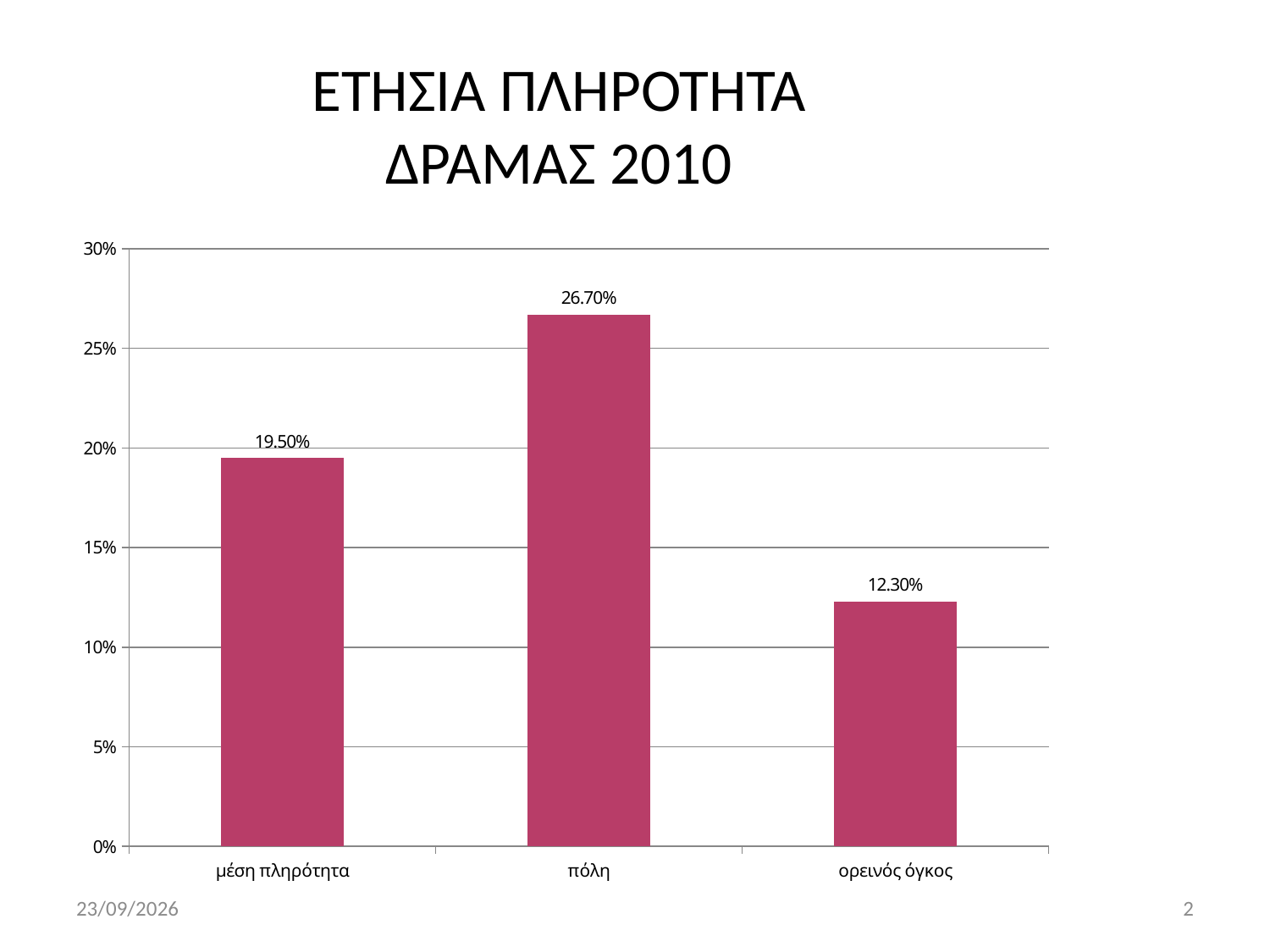
What is the difference between the values for πόλη and μέση πληρότητα? 7.20% Which category has the highest value? πόλη What is the value for πόλη? 26.70% What is the difference between the values for πόλη and ορεινός όγκος? 14.40% What kind of chart is shown on the slide? bar chart Is the value for ορεινός όγκος greater or less than 15%? less Which is larger, the value for μέση πληρότητα or the value for ορεινός όγκος? μέση πληρότητα What is the title of the slide? ΕΤΗΣΙΑ ΠΛΗΡΟΤΗΤΑ ΔΡΑΜΑΣ 2010 How many categories are shown on the x axis? 3 Which category has the lowest value? ορεινός όγκος What is the value for ορεινός όγκος? 12.30% What is the value for μέση πληρότητα? 19.50%